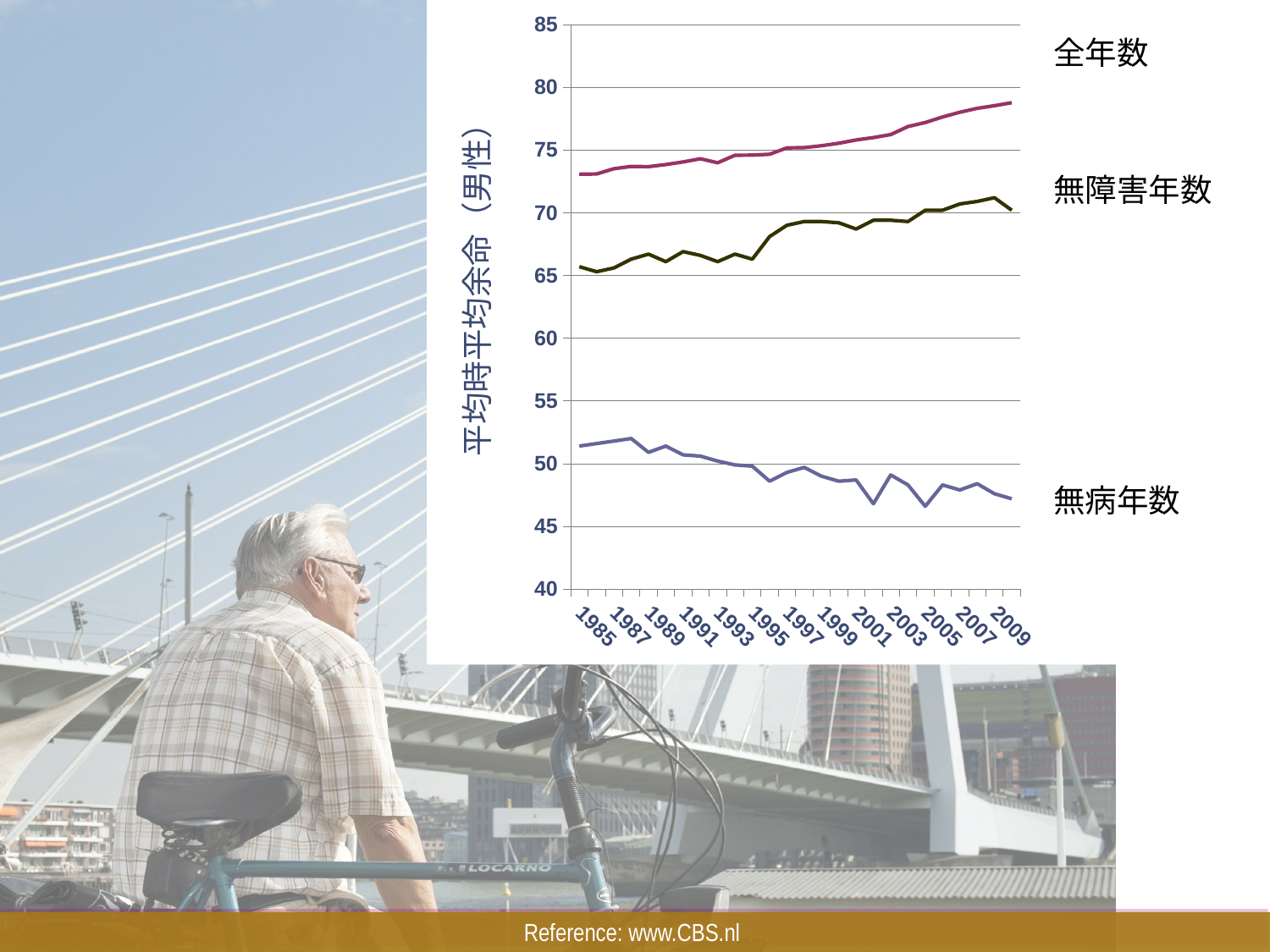
Is the value for 無障害年数 in 1985 greater or less than 70? less What is the first year and the last year labeled on the horizontal axis? 1985 and 2009 What is the label on the vertical axis of the chart? 平均時平均余命（男性） Does the 全年数 line rise or fall from 1985 to 2009? rise Does the 無病年数 line rise or fall from 1985 to 2009? fall In 2009, which is larger: 全年数 or 無障害年数? 全年数 Is the value for 全年数 in 2009 greater or less than 75? greater How many series are plotted on the chart? 3 Is the value for 無病年数 in 2009 greater or less than 50? less Which series has the highest values throughout the chart? 全年数 Which series has the lowest values throughout the chart? 無病年数 What kind of chart is shown on the slide? line chart